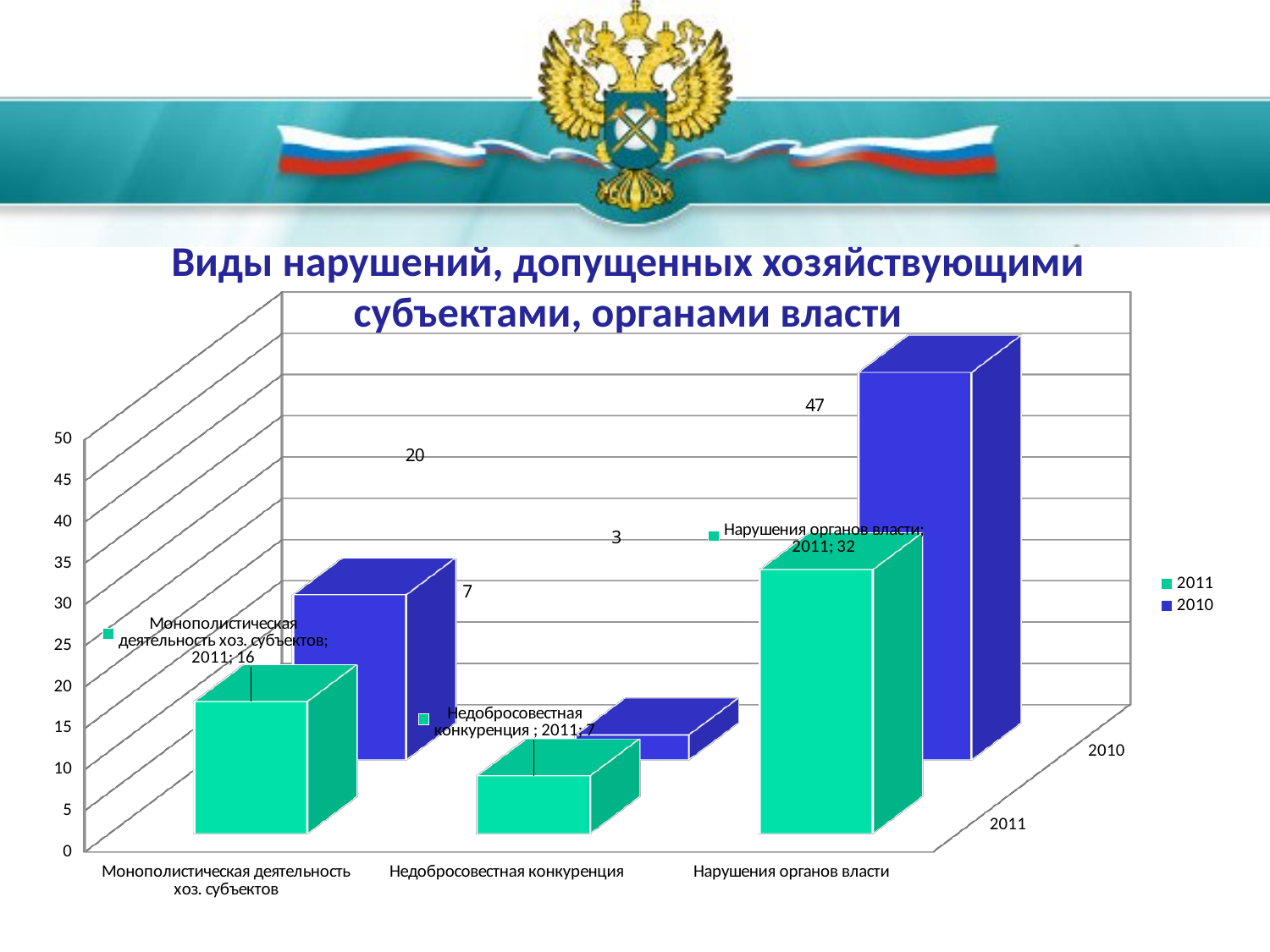
What is the value for Недобросовестная конкуренция in the 2010 series? 3 Which category has the highest value in the 2011 series? Нарушения органов власти For Нарушения органов власти, which series has the larger value, 2010 or 2011? 2010 What kind of chart is shown on the slide? Bar chart Which category has the lowest value in the 2010 series? Недобросовестная конкуренция What is the value for Монополистическая деятельность хоз. субъектов in the 2011 series? 16 What is the value for Нарушения органов власти in the 2011 series? 32 What is the value for Недобросовестная конкуренция in the 2011 series? 7 How many categories are shown on the x axis? 3 How many series does the legend list? 2 What is the value for Нарушения органов власти in the 2010 series? 47 What is the difference between the 2010 and 2011 values for Нарушения органов власти? 15